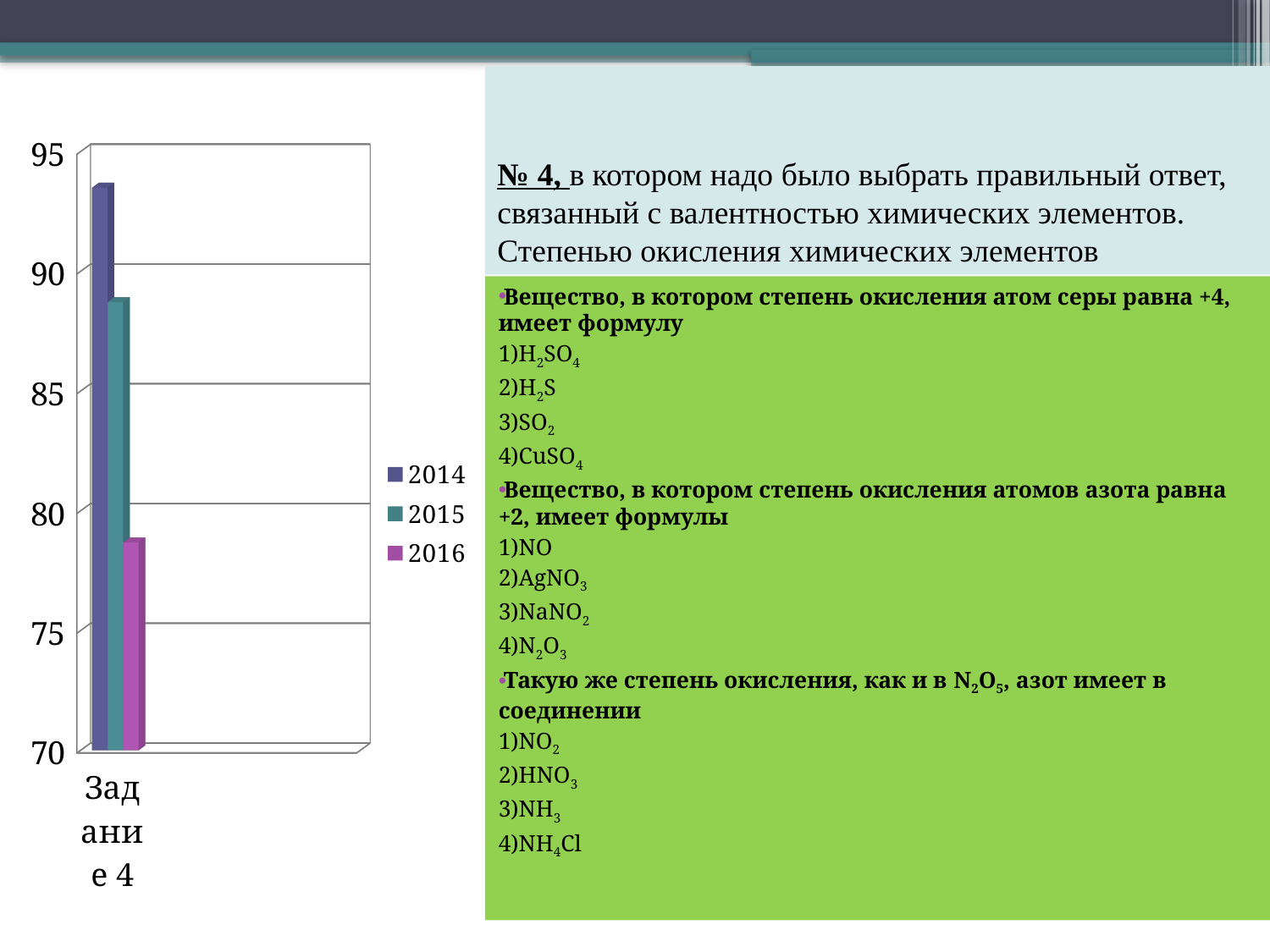
What kind of chart is shown on the slide? bar chart Is the value for 2016 greater or less than 80? less Which is larger for Задание 4, the value for 2015 or the value for 2016? 2015 Which year has the highest value for Задание 4? 2014 Is the value for 2014 greater or less than 90? greater How many categories are shown on the x axis of the chart? 1 Do the values for Задание 4 rise or fall from 2014 to 2016? fall Is the value for 2015 greater or less than 85? greater What are the entries listed in the chart legend? 2014, 2015, 2016 How many series does the chart legend list? 3 Which year has the lowest value for Задание 4? 2016 What is the category label shown on the x axis of the chart? Задание 4